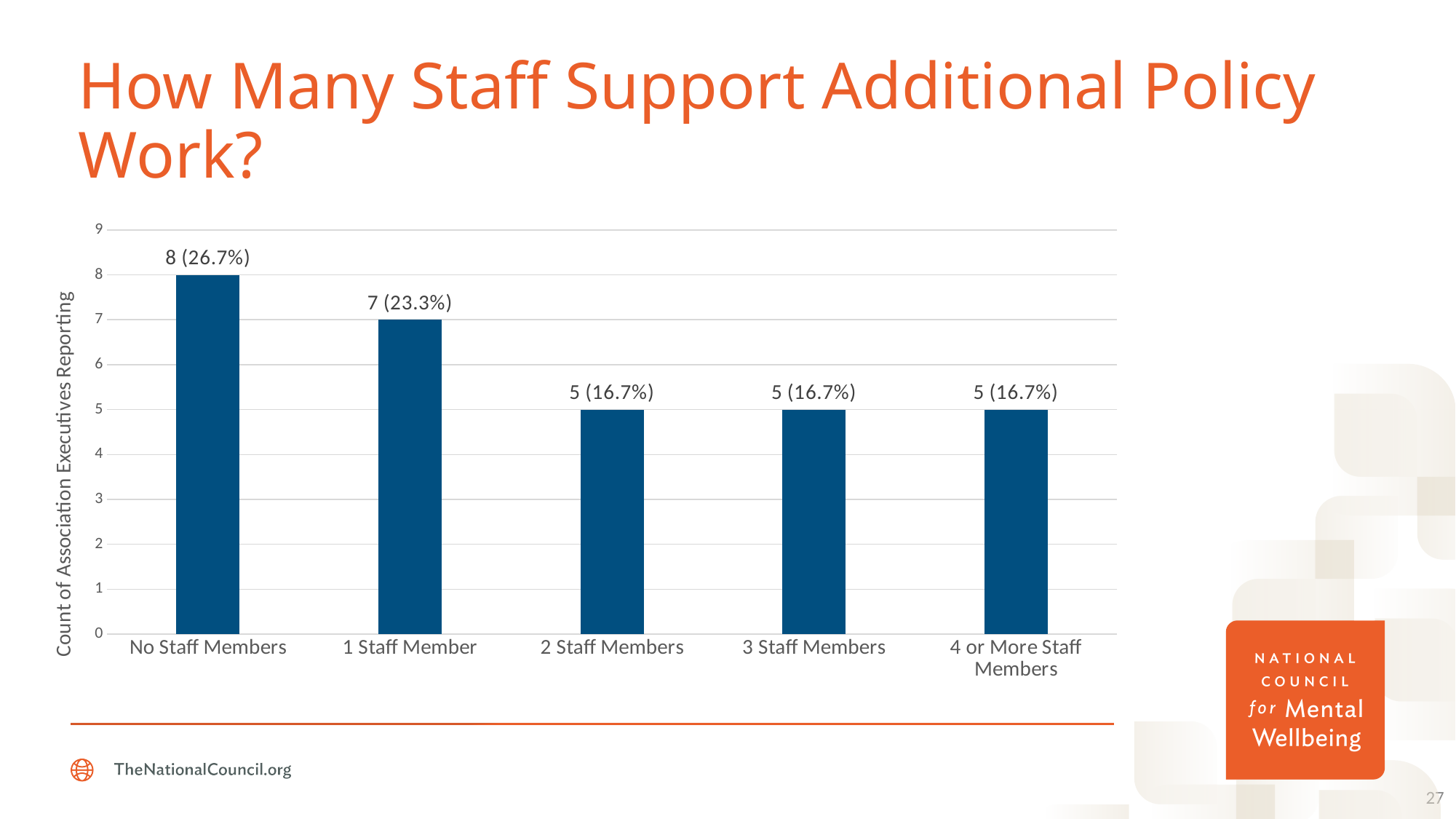
Is the value for 1 Staff Member greater or less than 6? greater What is the label of the y axis? Count of Association Executives Reporting What kind of chart is shown on the slide? Bar chart Which category has the highest count of association executives reporting? No Staff Members What is the difference in count between No Staff Members and 2 Staff Members? 3 What is the count of association executives reporting for No Staff Members? 8 (26.7%) How many categories are shown on the x axis? 5 What is the count of association executives reporting for 1 Staff Member? 7 (23.3%) What is the count of association executives reporting for 4 or More Staff Members? 5 (16.7%) Do the values rise or fall from No Staff Members to 2 Staff Members? Fall Which has a larger count, 1 Staff Member or 3 Staff Members? 1 Staff Member What is the difference in count between No Staff Members and 1 Staff Member? 1